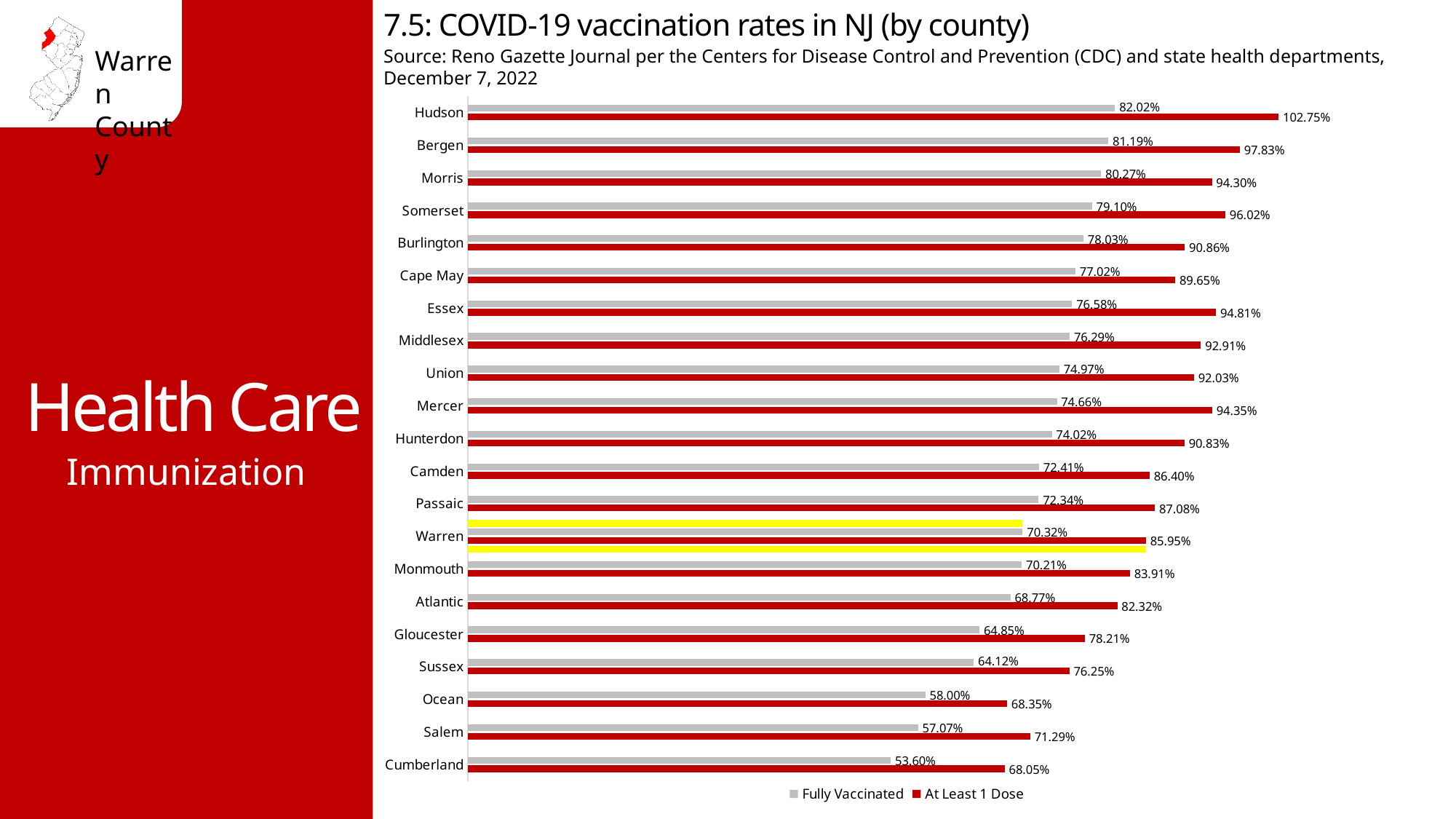
What is the At Least 1 Dose rate for Cumberland county? 68.05% Which county has the highest Fully Vaccinated rate? Hudson What is the Fully Vaccinated rate for Warren county? 70.32% Which series is shown in red in the chart? At Least 1 Dose Which county has the lowest Fully Vaccinated rate? Cumberland Which county has the higher At Least 1 Dose rate, Somerset or Morris? Somerset What is the At Least 1 Dose rate for Hudson county? 102.75% What is the difference between the At Least 1 Dose rate and the Fully Vaccinated rate for Warren county? 15.63 percentage points How many series does the legend list? 2 What is the Fully Vaccinated rate for Sussex county? 64.12% What kind of chart is shown on the slide? Bar chart How many counties are shown in the chart? 21